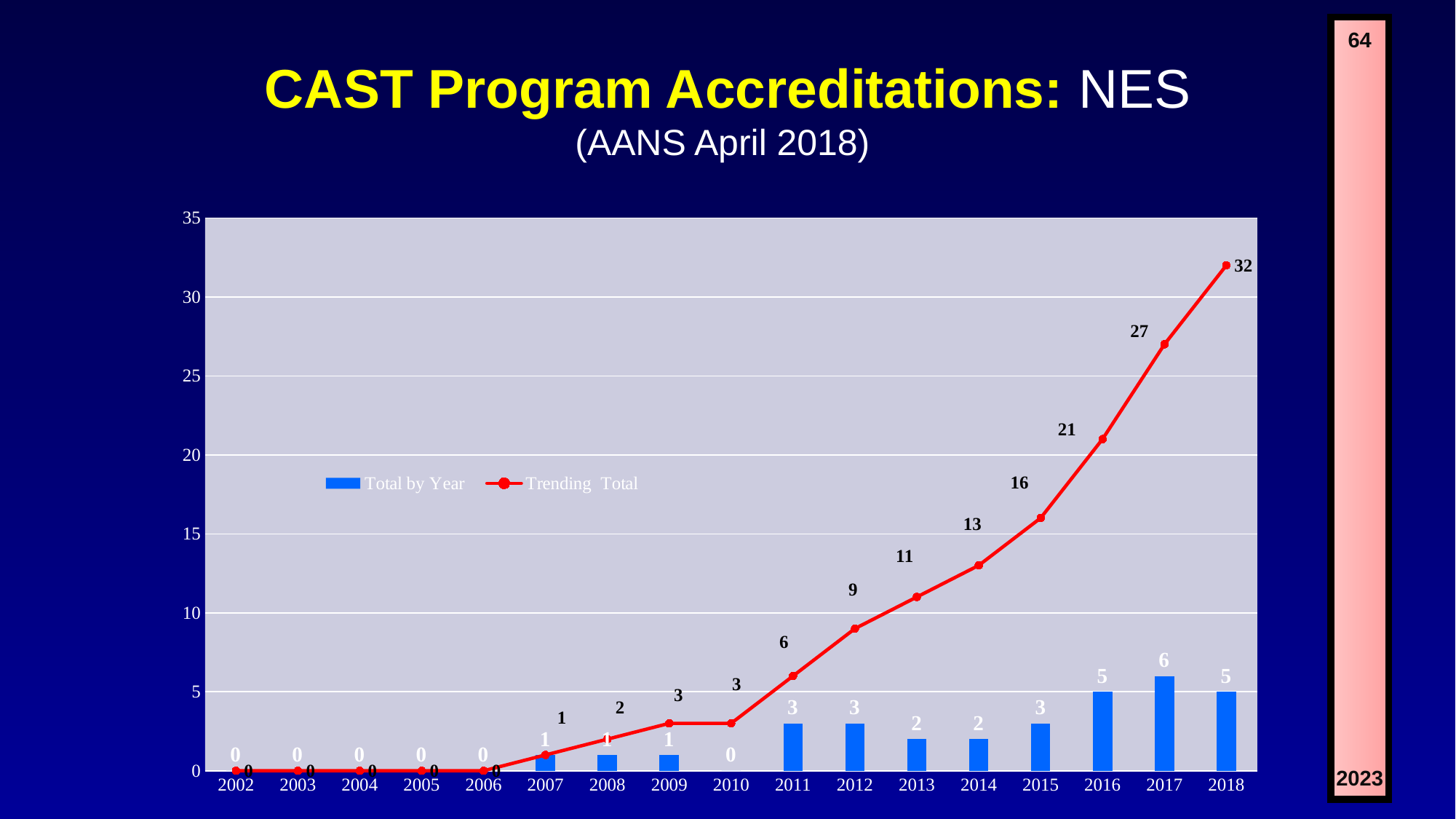
How many years are shown on the x axis? 17 What is the Total by Year value for 2011? 3 Does the Trending Total line rise or fall from 2010 to 2018? rise What is the Trending Total value for 2014? 13 What are the two series named in the legend? Total by Year and Trending Total What is the Total by Year value for 2017? 6 Which year has the highest Total by Year bar? 2017 How many series does the legend list? 2 What is the difference between the Trending Total for 2018 and for 2017? 5 What is the Trending Total value for 2018? 32 Which is larger, the Total by Year for 2016 or for 2013? 2016 Is the Trending Total for 2016 greater or less than 20? greater